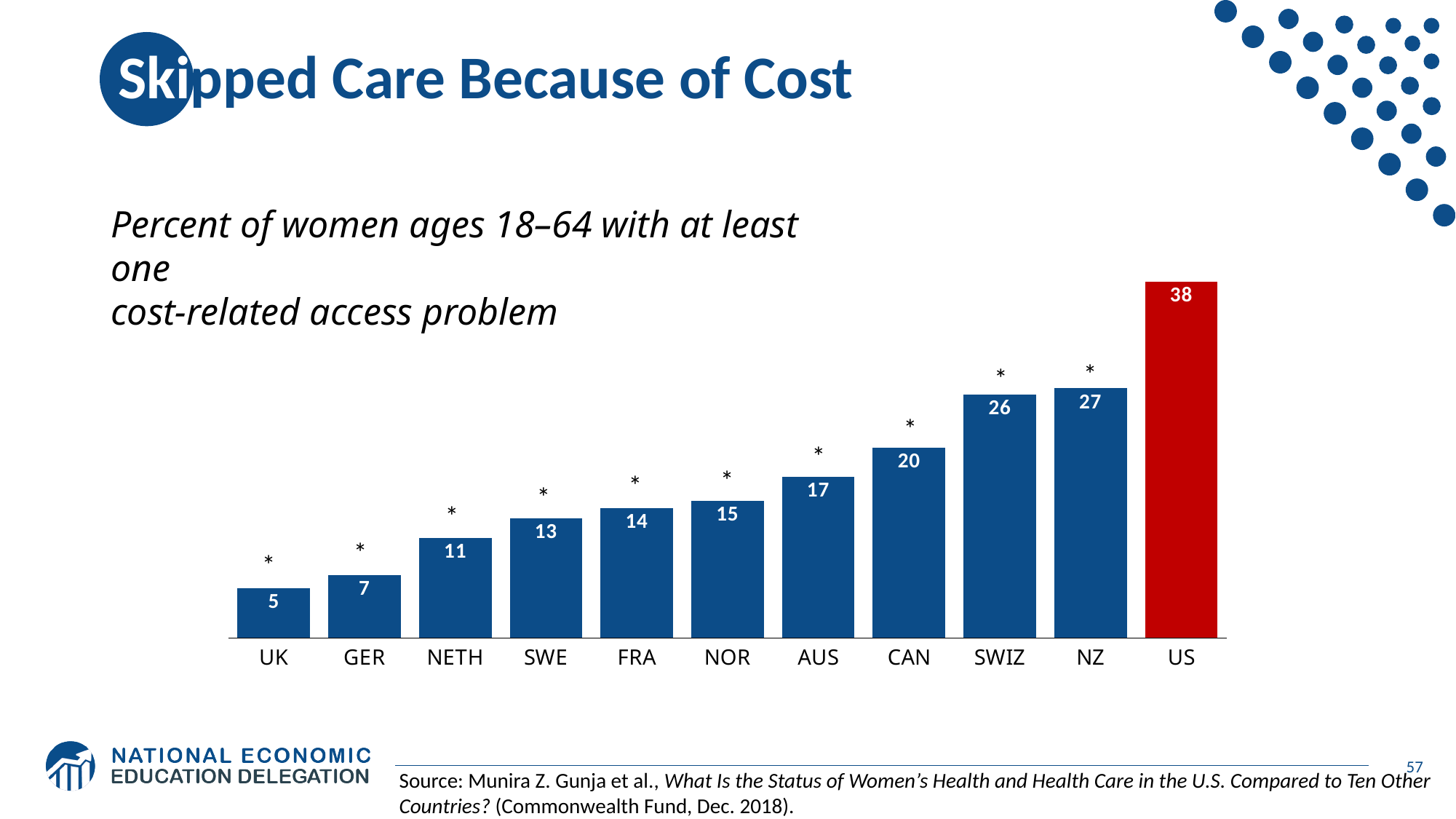
Which has a larger value, FRA or NOR? NOR Which country has the highest value? US Which has a larger value, NETH or SWE? SWE What is the difference between the values for the US and NZ? 11 What is the value for Germany (GER)? 7 What is the difference between the values for SWIZ and AUS? 9 Do the values rise or fall from left to right across the x axis? Rise What is the value for Canada (CAN)? 20 How many countries are shown in the chart? 11 What is the value for the US? 38 Which country has the lowest value? UK What kind of chart is shown on the slide? Bar chart